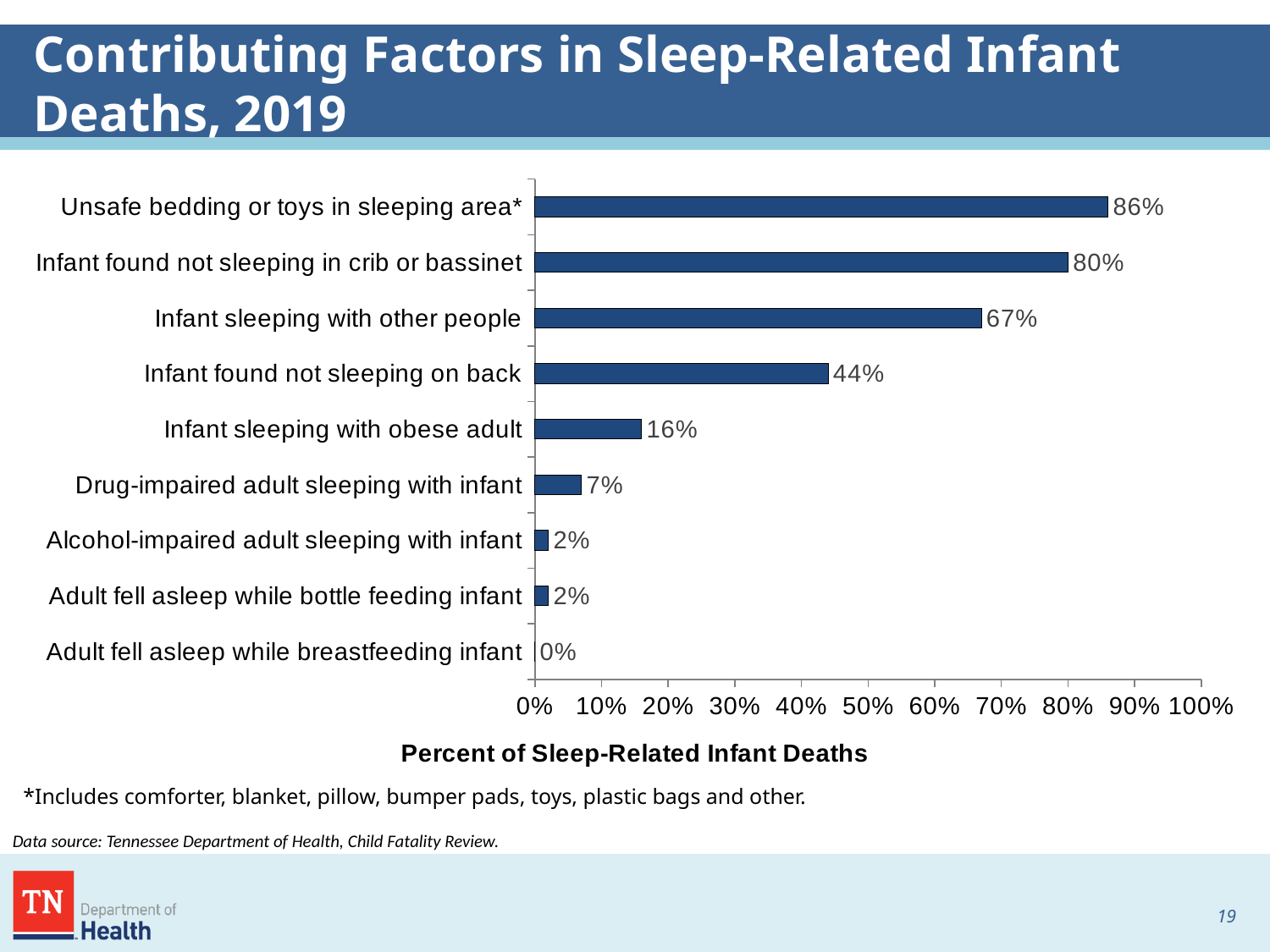
What kind of chart is shown on the slide? Bar chart How many contributing factors are shown in the chart? 9 What is the value for 'Infant sleeping with obese adult'? 16% What is the title of the slide's chart? Contributing Factors in Sleep-Related Infant Deaths, 2019 Is the value for 'Infant sleeping with other people' greater or less than 60%? greater What is the value for 'Infant found not sleeping on back'? 44% Which contributing factor has the lowest percentage? Adult fell asleep while breastfeeding infant Which contributing factor has the highest percentage? Unsafe bedding or toys in sleeping area* What is the difference between 'Infant found not sleeping in crib or bassinet' and 'Infant sleeping with other people'? 13% What is the label of the horizontal axis? Percent of Sleep-Related Infant Deaths What percent of sleep-related infant deaths involved unsafe bedding or toys in the sleeping area? 86% Which is larger: 'Drug-impaired adult sleeping with infant' or 'Alcohol-impaired adult sleeping with infant'? Drug-impaired adult sleeping with infant